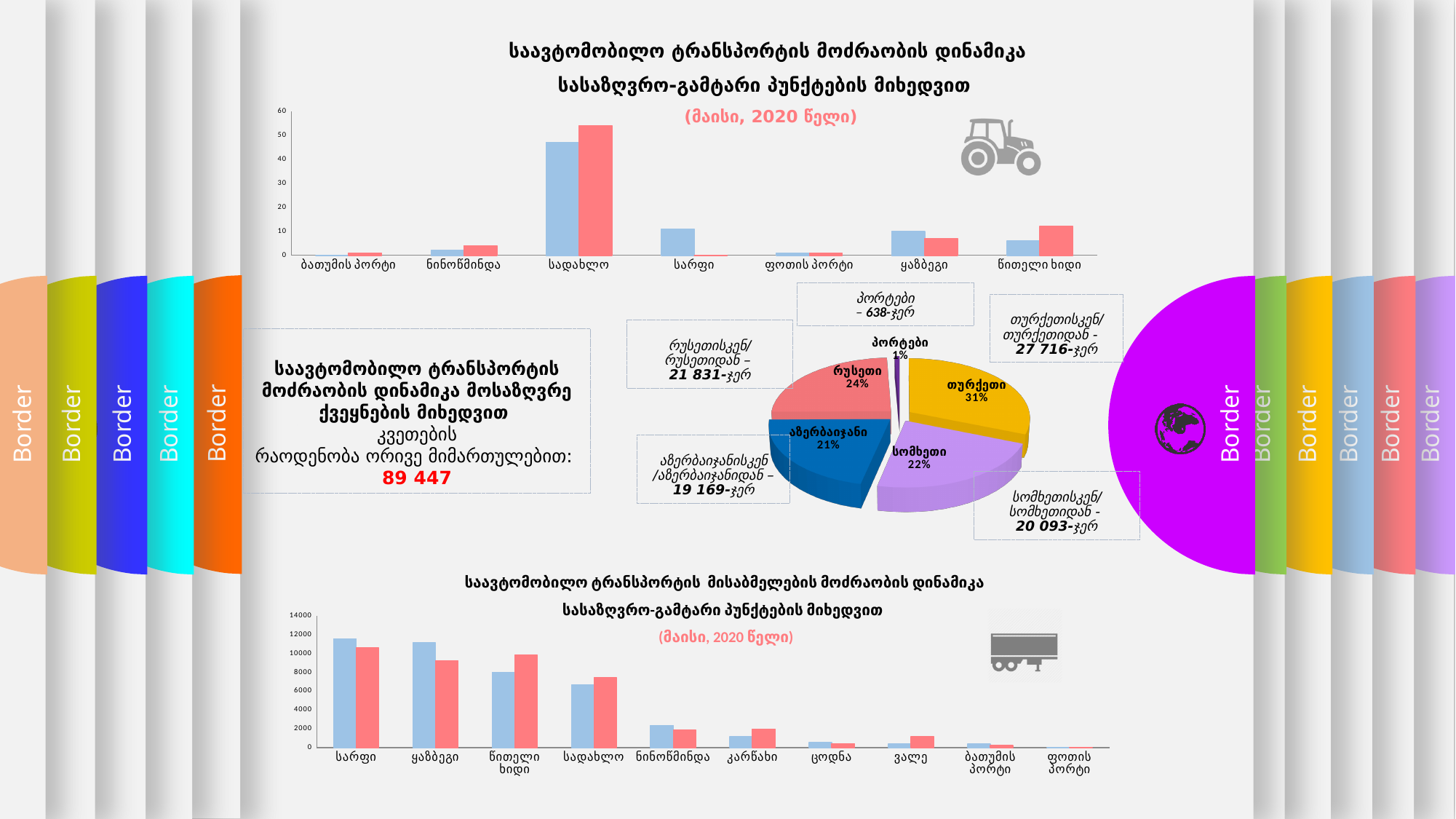
In the pie chart in the middle of the slide, how many slices are there? 5 In the top bar chart (with the tractor icon), how many categories are shown on the x axis? 7 In the top bar chart (with the tractor icon), which category has the highest bars? სადახლო In the pie chart in the middle of the slide, what share does აზერბაიჯანი have? 21% In the pie chart in the middle of the slide, how many percentage points larger is the თურქეთი slice than the რუსეთი slice? 7 In the pie chart in the middle of the slide, which slice is the largest? თურქეთი In the bottom bar chart (with the truck icon), is the blue bar for ნინოწმინდა greater or less than 4000? less In the bottom bar chart (with the truck icon), how many categories are shown on the x axis? 10 What kind of chart is the top chart on the slide (with the tractor icon)? bar chart In the pie chart in the middle of the slide, which slice is the smallest? პორტები In the pie chart in the middle of the slide, which slice is larger: სომხეთი or რუსეთი? რუსეთი In the pie chart in the middle of the slide, what share does თურქეთი have? 31%